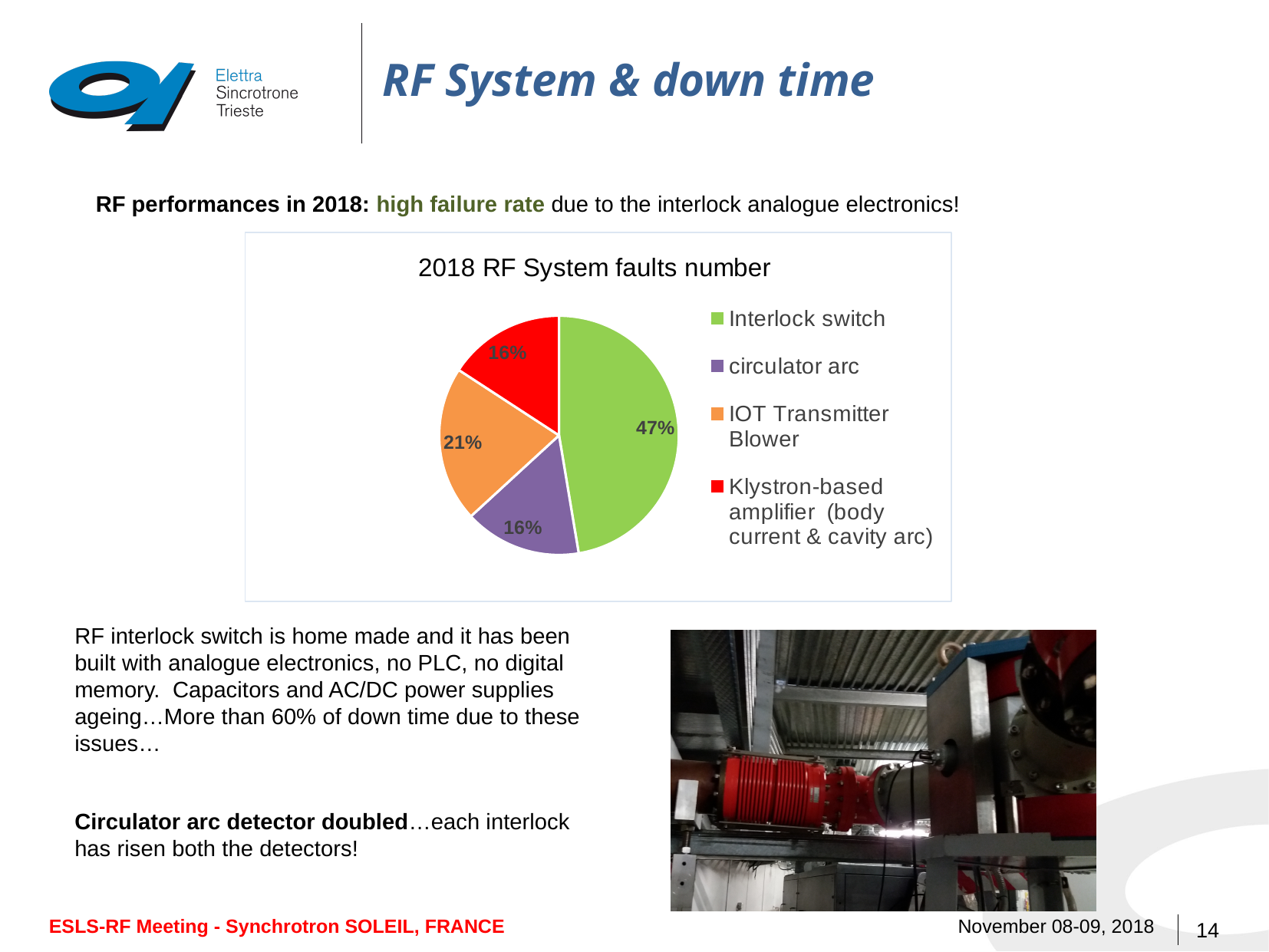
What is the difference in percentage points between the Interlock switch share and the IOT Transmitter Blower share? 26 Which is larger, the share for Interlock switch or the share for IOT Transmitter Blower? Interlock switch What is the title of the chart? 2018 RF System faults number What share of the pie does Interlock switch account for? 47% How many slices does the pie chart have? 4 How many entries does the legend list? 4 What colour is the Interlock switch slice? green What share of the pie does Klystron-based amplifier (body current & cavity arc) account for? 16% What share of the pie does circulator arc account for? 16% Which category has the largest slice of the pie? Interlock switch What type of chart is shown on the slide? pie chart